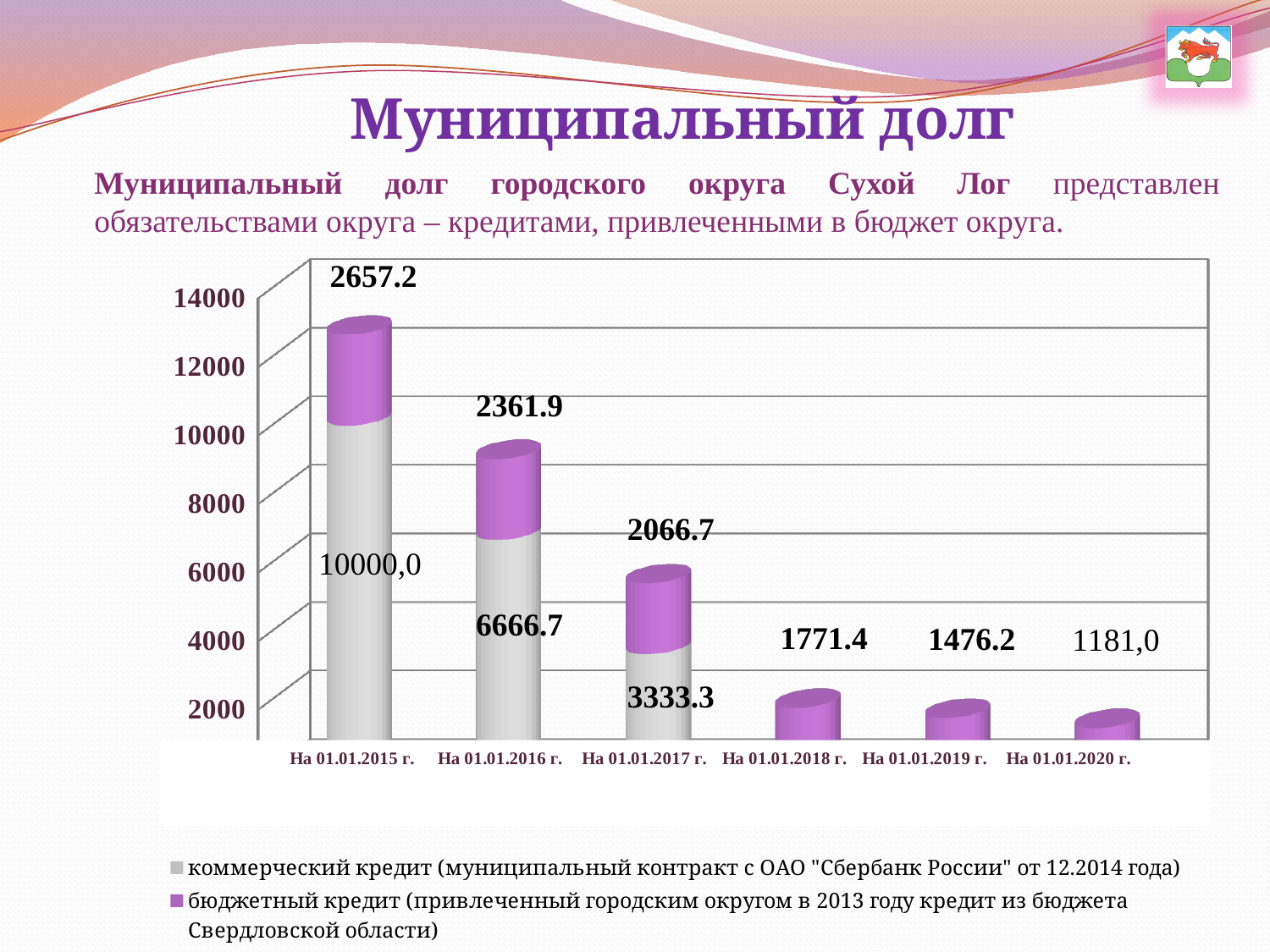
Is the total height of the bar for На 01.01.2015 г. greater or less than 12000? greater How many series does the legend list? 2 What is the value of the commercial credit (коммерческий кредит) series for На 01.01.2016 г.? 6666.7 What is the value of the budget credit (бюджетный кредит) series for На 01.01.2020 г.? 1181,0 How many dates (categories) are shown on the x axis? 6 What is the total of the stacked bar for На 01.01.2016 г.? 9028.6 For which date is the budget credit (бюджетный кредит) value the highest? На 01.01.2015 г. What is the difference between the budget credit values for На 01.01.2015 г. and На 01.01.2016 г.? 295.3 For which date is the budget credit (бюджетный кредит) value the lowest? На 01.01.2020 г. What is the value of the commercial credit (коммерческий кредит) series for На 01.01.2017 г.? 3333.3 What is the value of the budget credit (бюджетный кредит) series for На 01.01.2015 г.? 2657.2 Which is larger: the commercial credit value for На 01.01.2016 г. or for На 01.01.2017 г.? На 01.01.2016 г.